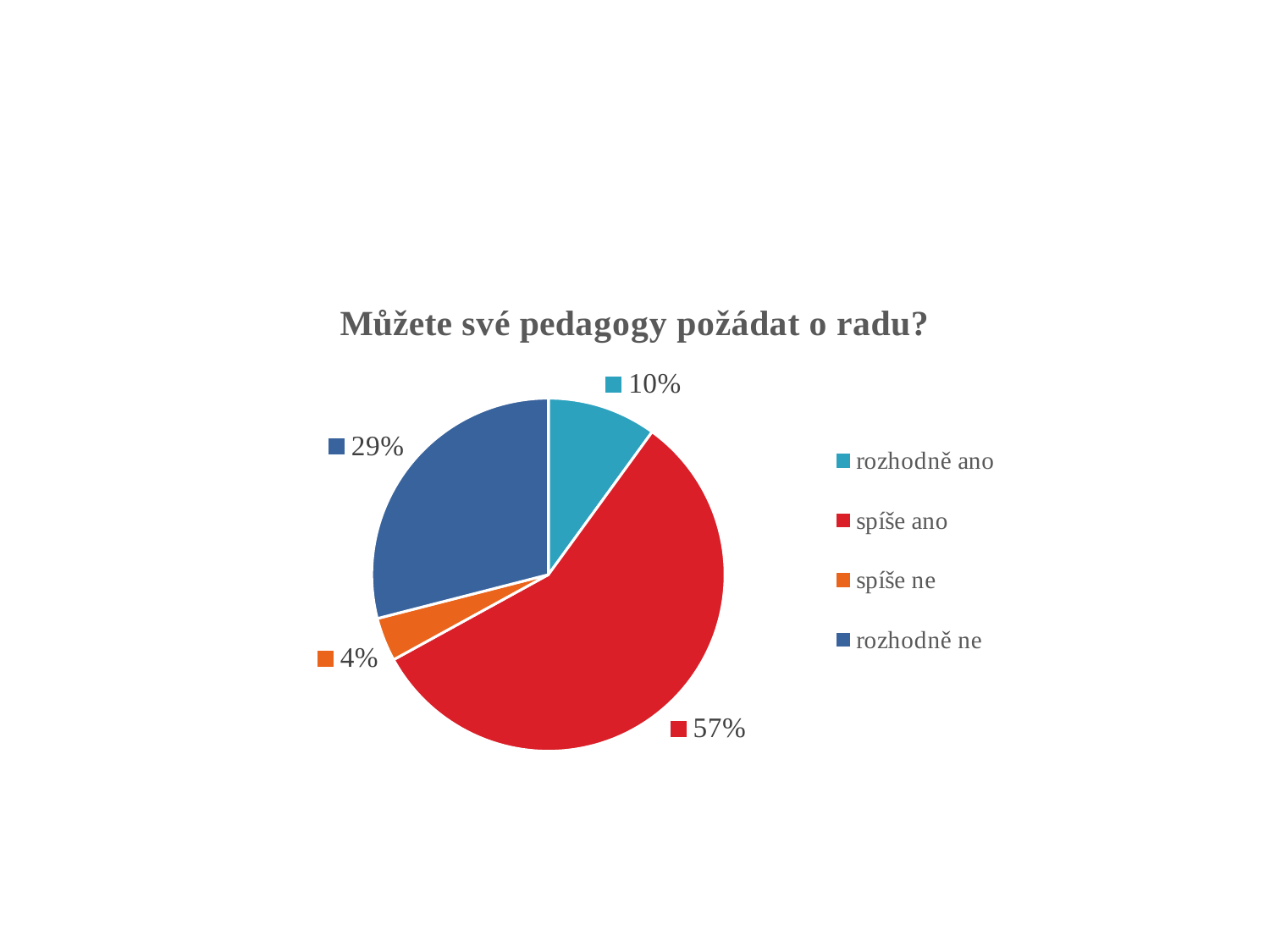
What colour is the slice for "spíše ne"? orange What percentage of respondents answered "spíše ne"? 4% What is the title of the chart? Můžete své pedagogy požádat o radu? What kind of chart is shown on the slide? pie chart Which answer has the largest share of the pie? spíše ano How many categories does the legend list? 4 Which is larger, the share for "rozhodně ano" or the share for "rozhodně ne"? rozhodně ne What is the difference in percentage points between "spíše ano" and "rozhodně ne"? 28 What percentage of respondents answered "rozhodně ne"? 29% What percentage of respondents answered "spíše ano"? 57% Which answer has the smallest share of the pie? spíše ne What percentage of respondents answered "rozhodně ano"? 10%